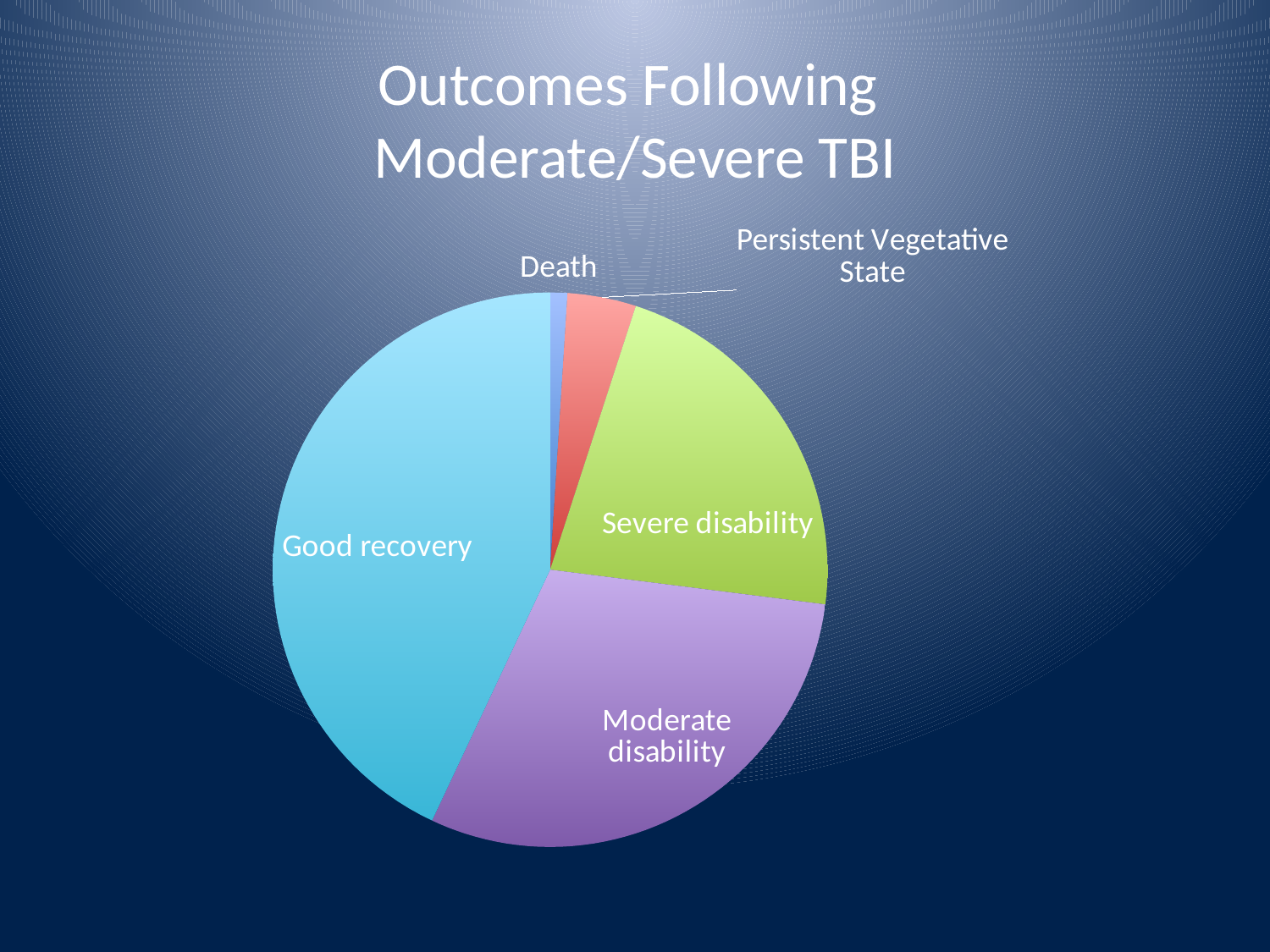
Which slice is larger, Severe disability or Persistent Vegetative State? Severe disability Which slice is larger, Moderate disability or Severe disability? Moderate disability How many outcome categories (slices) does the pie chart show? 5 Which outcome category has the smallest slice of the pie? Death What kind of chart is shown on the slide? pie chart Which slice is larger, Moderate disability or Persistent Vegetative State? Moderate disability Which outcome category has the largest slice of the pie? Good recovery What is the title of the chart? Outcomes Following Moderate/Severe TBI What colour is the Good recovery slice? light blue